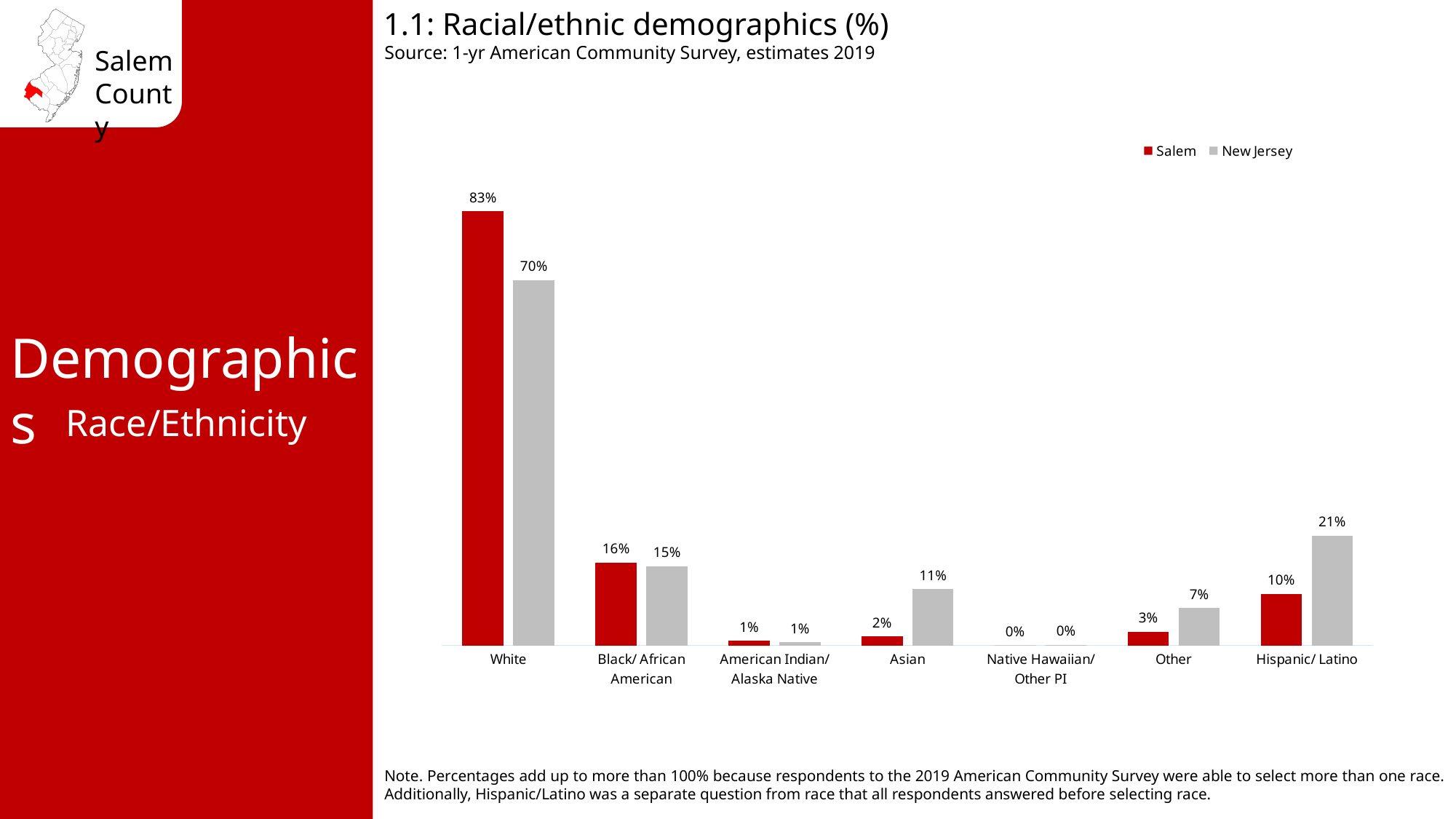
Which category has the highest Salem value? White How many series does the legend list? 2 What is the difference between the New Jersey and Salem values for Hispanic/ Latino? 11% What is the New Jersey value for Hispanic/ Latino? 21% What is the Salem value for White? 83% Which is larger for Black/ African American, the Salem value or the New Jersey value? Salem What is the Salem value for Other? 3% What is the difference between the Salem and New Jersey values for White? 13% Which category has the lowest New Jersey value? Native Hawaiian/ Other PI What is the New Jersey value for Asian? 11% What kind of chart is shown? Bar chart How many categories are shown on the x axis? 7